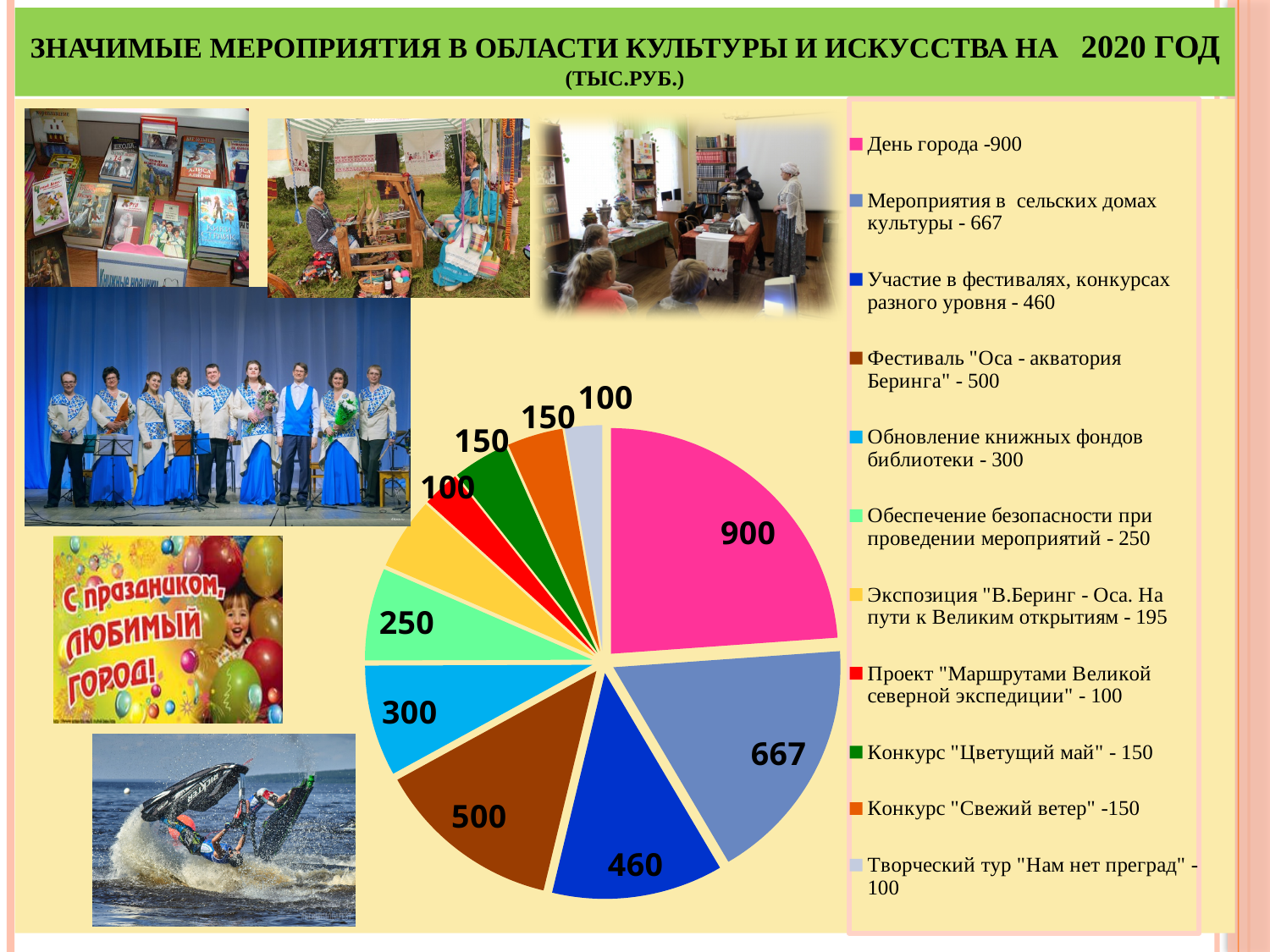
What is the value for "Обеспечение безопасности при проведении мероприятий"? 250 What kind of chart is shown on the slide? Pie chart What is the value for "День города" in the pie chart? 900 What is the value for "Обновление книжных фондов библиотеки"? 300 What is the difference between the values for "Фестиваль "Оса - акватория Беринга"" and "Участие в фестивалях, конкурсах разного уровня"? 40 What is the value for "Мероприятия в сельских домах культуры"? 667 What is the difference between the values for "День города" and "Мероприятия в сельских домах культуры"? 233 Which is larger: "Фестиваль "Оса - акватория Беринга"" or "Участие в фестивалях, конкурсах разного уровня"? Фестиваль "Оса - акватория Беринга" How many entries does the legend list? 11 How many slices does the pie chart have? 11 What colour is the slice for "День города"? Pink Which category has the largest slice in the pie chart? День города